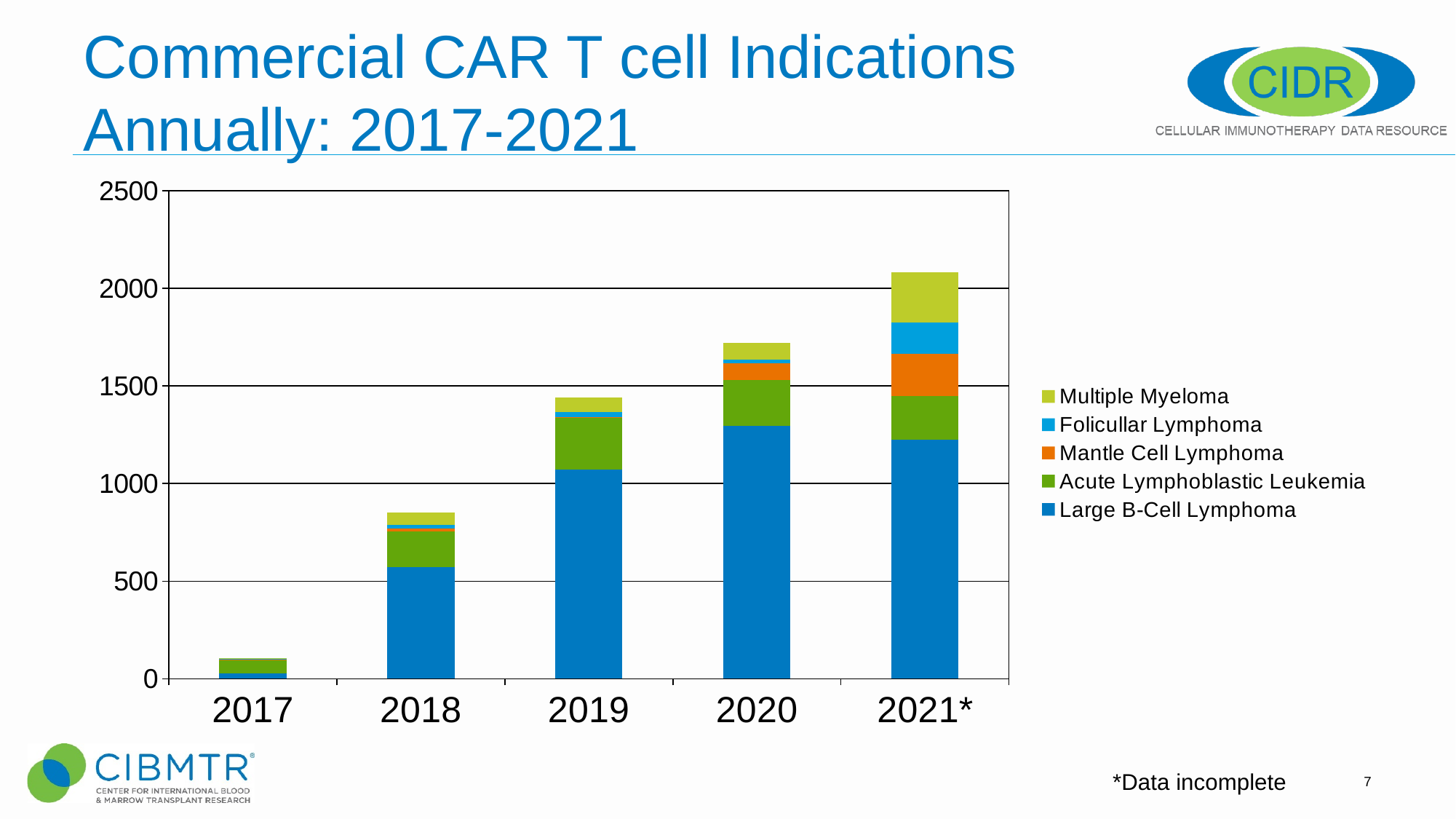
How many years are shown on the x axis of the chart? 5 Do the total bar heights rise or fall from 2017 to 2021*? Rise Which year has the tallest stacked bar in the chart? 2021* What kind of chart is shown on the slide? Stacked bar chart Is the total height of the 2019 bar greater or less than 1500? less Is the total height of the 2021* bar greater or less than 2000? greater Is the Large B-Cell Lymphoma value for 2019 greater or less than 1000? greater How many series does the chart's legend list? 5 Which series is listed first (at the top) in the chart's legend? Multiple Myeloma Which year has the shortest stacked bar in the chart? 2017 What does the asterisk on the 2021* label indicate, according to the slide? Data incomplete